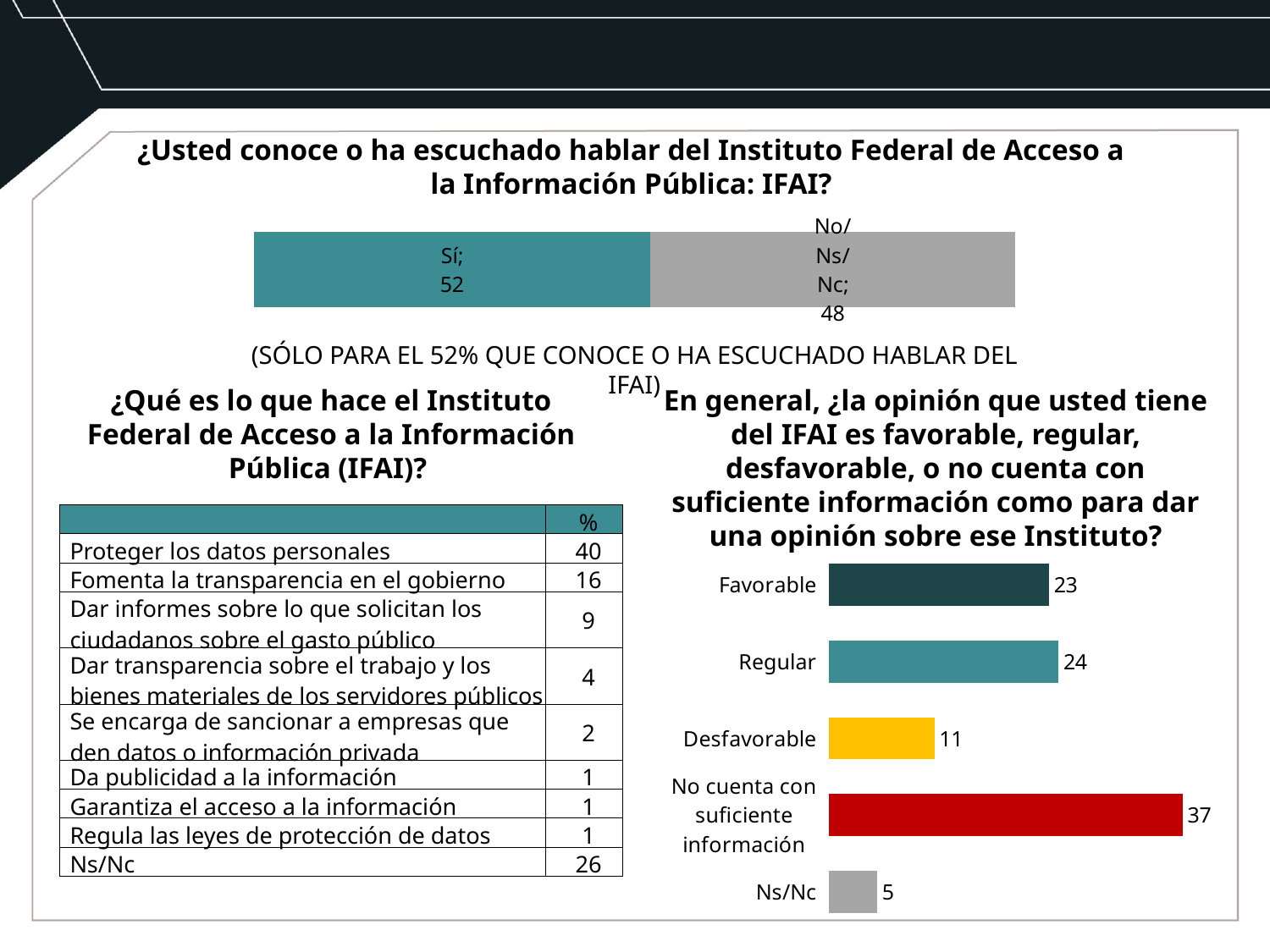
In the bottom-right chart about opinion of the IFAI, which is larger: "Favorable" or "Desfavorable"? Favorable In the top chart about whether respondents know the IFAI, what is the value for "Sí"? 52 In the bottom-right chart about opinion of the IFAI, what is the value for "No cuenta con suficiente información"? 37 In the bottom-right chart about opinion of the IFAI, what colour is the bar for "Desfavorable"? Yellow In the bottom-right chart about opinion of the IFAI, what is the difference between "No cuenta con suficiente información" and "Favorable"? 14 What kind of chart is the bottom-right chart about opinion of the IFAI? Bar chart In the top chart about whether respondents know the IFAI, what is the value for "No/Ns/Nc"? 48 In the bottom-right chart about opinion of the IFAI, what is the value for "Desfavorable"? 11 In the bottom-right chart about opinion of the IFAI, which category has the highest value? No cuenta con suficiente información In the bottom-right chart about opinion of the IFAI, which category has the lowest value? Ns/Nc In the top chart about whether respondents know the IFAI, what is the total of the two segments? 100 In the bottom-right chart about opinion of the IFAI, how many categories are shown? 5